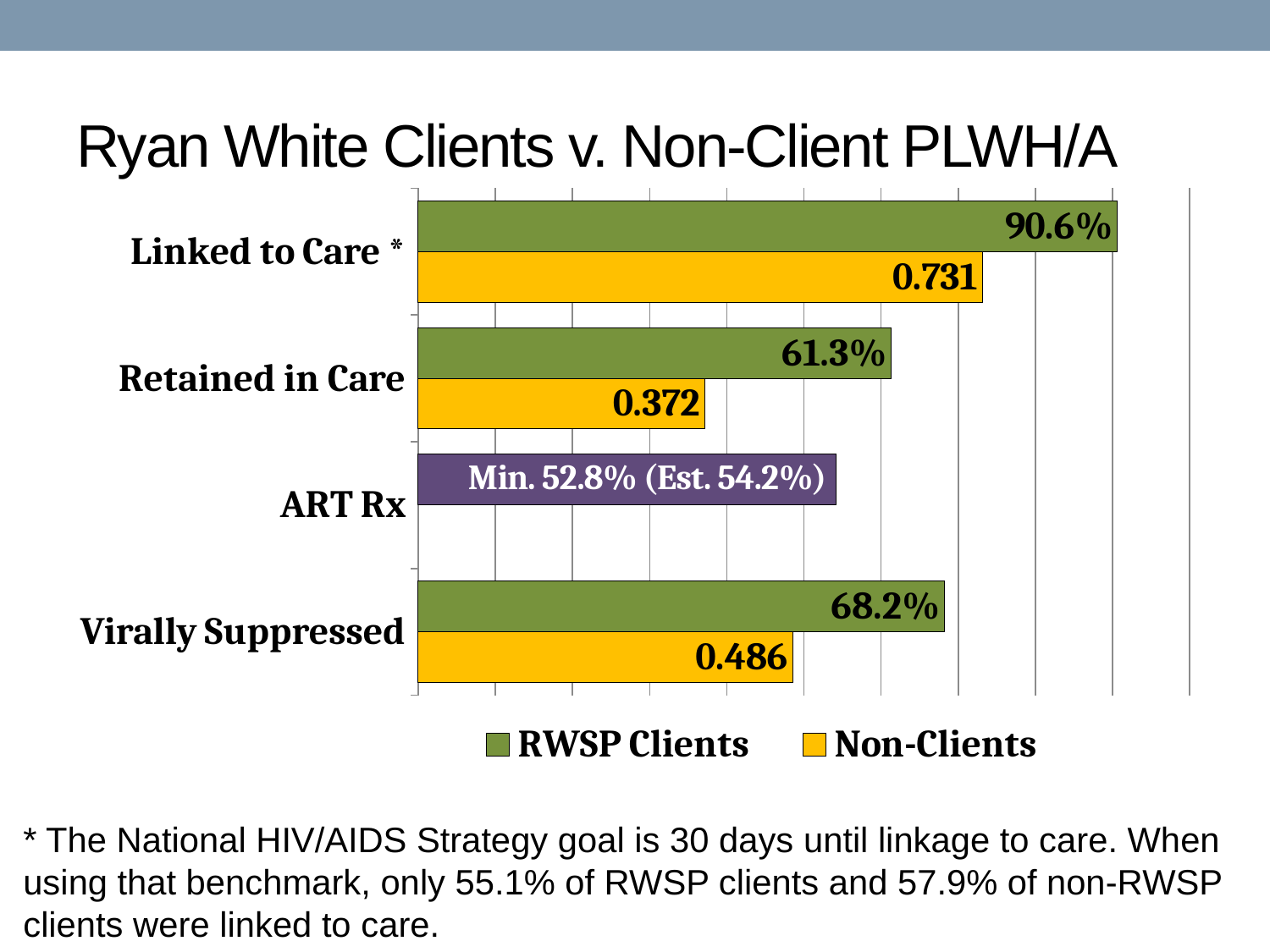
Which category has the highest value for RWSP Clients? Linked to Care * In the Retained in Care category, which series has the larger value, RWSP Clients or Non-Clients? RWSP Clients For RWSP Clients, what is the difference between the Linked to Care * value and the Retained in Care value? 29.3% What is the value for Non-Clients in the Virally Suppressed category? 0.486 How many categories are shown on the chart? 4 What is the value for RWSP Clients in the Virally Suppressed category? 68.2% What label is printed on the bar for the ART Rx category? Min. 52.8% (Est. 54.2%) How many series does the legend list? 2 Which category has the lowest value for Non-Clients? Retained in Care What kind of chart is shown on the slide? Bar chart What is the value for RWSP Clients in the Linked to Care * category? 90.6% What is the value for Non-Clients in the Retained in Care category? 0.372